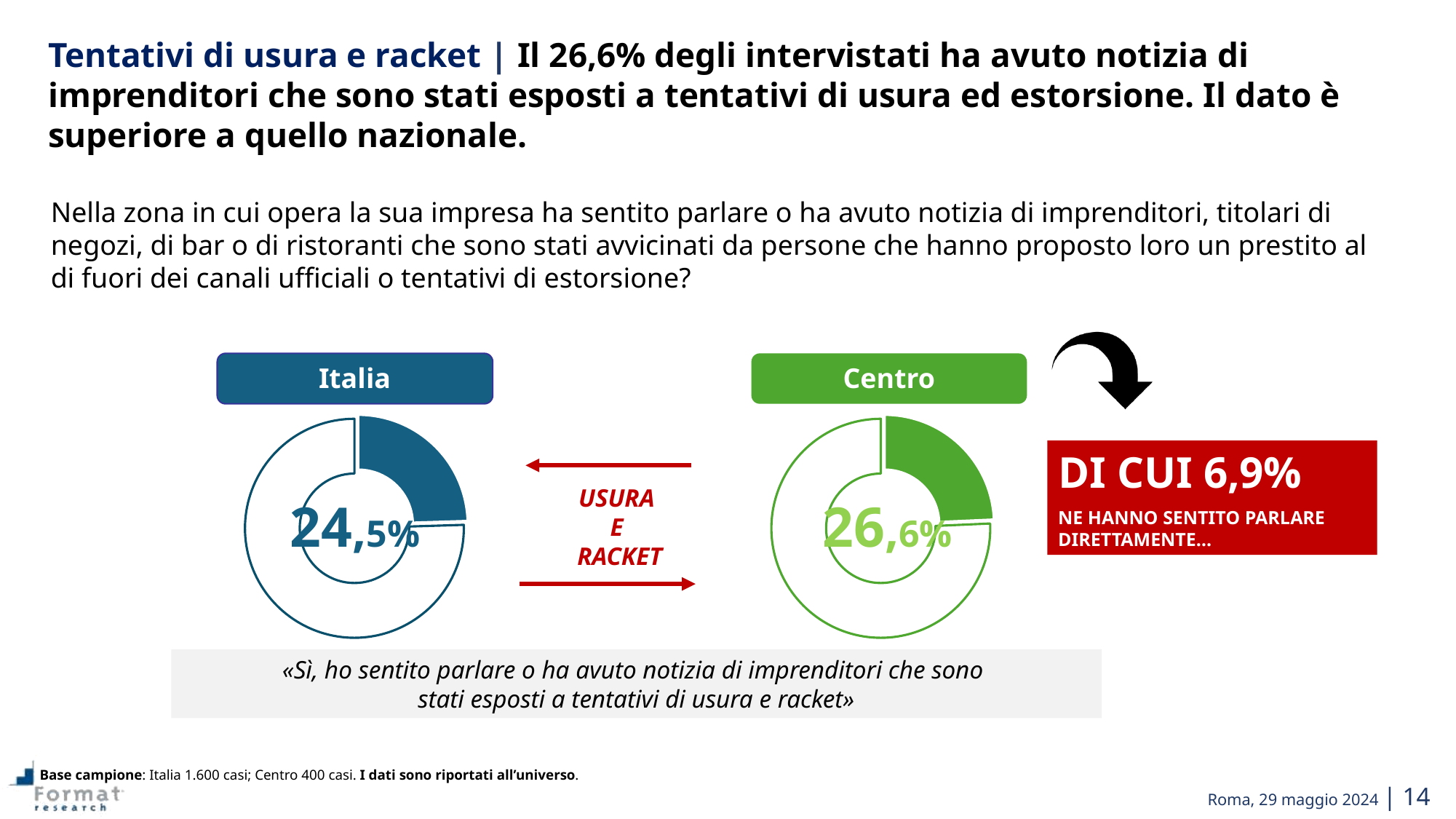
Which of the two donut charts, Italia or Centro, shows the lower percentage? Italia What kind of chart is used to show the Italia and Centro values? Donut (pie) chart What is the difference in percentage points between the Centro value and the Italia value? 2,1 Which of the two donut charts, Italia or Centro, shows the higher percentage? Centro In the Italia donut chart, what percentage is shown? 24,5% What share of the Centro donut chart does the highlighted slice represent? 26,6% What colour is the highlighted slice in the Italia donut chart? Blue What colour is the highlighted slice in the Centro donut chart? Green Is the Italia value of 24,5% greater or less than the Centro value of 26,6%? less In the Centro donut chart, what percentage is shown? 26,6% How many donut charts are shown on the slide? 2 What share of the Italia donut chart does the highlighted slice represent? 24,5%